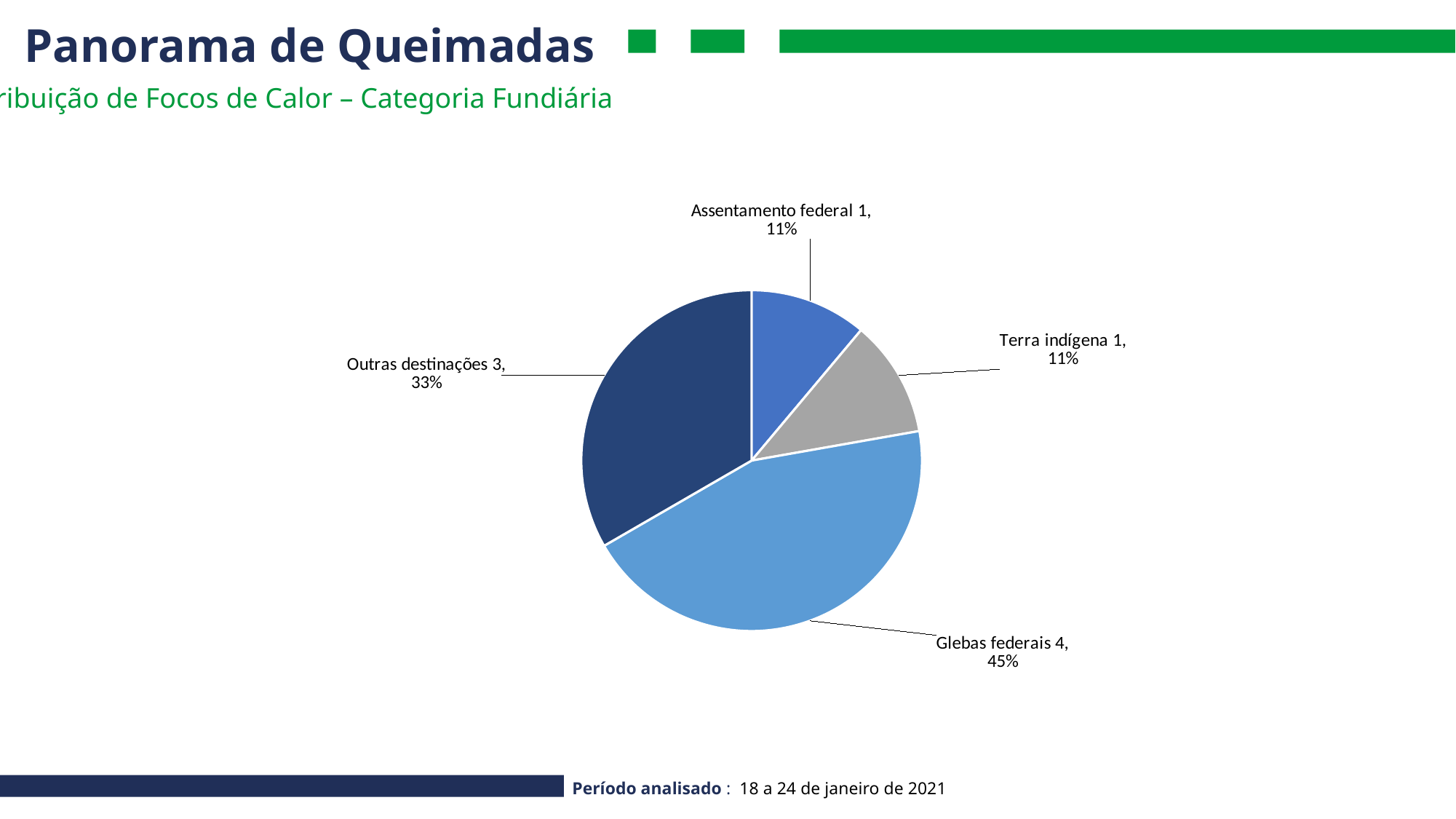
What is the value shown for Glebas federais? 4 How many slices does the pie chart have? 4 What share of the pie does Glebas federais represent? 45% What is the value shown for Outras destinações? 3 What share of the pie does Outras destinações represent? 33% What is the value shown for Assentamento federal? 1 What kind of chart is shown on the slide? pie chart Which is larger, the slice for Outras destinações or the slice for Terra indígena? Outras destinações What colour is the Glebas federais slice? light blue Which category has the largest slice of the pie? Glebas federais What share of the pie does Terra indígena represent? 11% What is the difference in value between Glebas federais and Outras destinações? 1